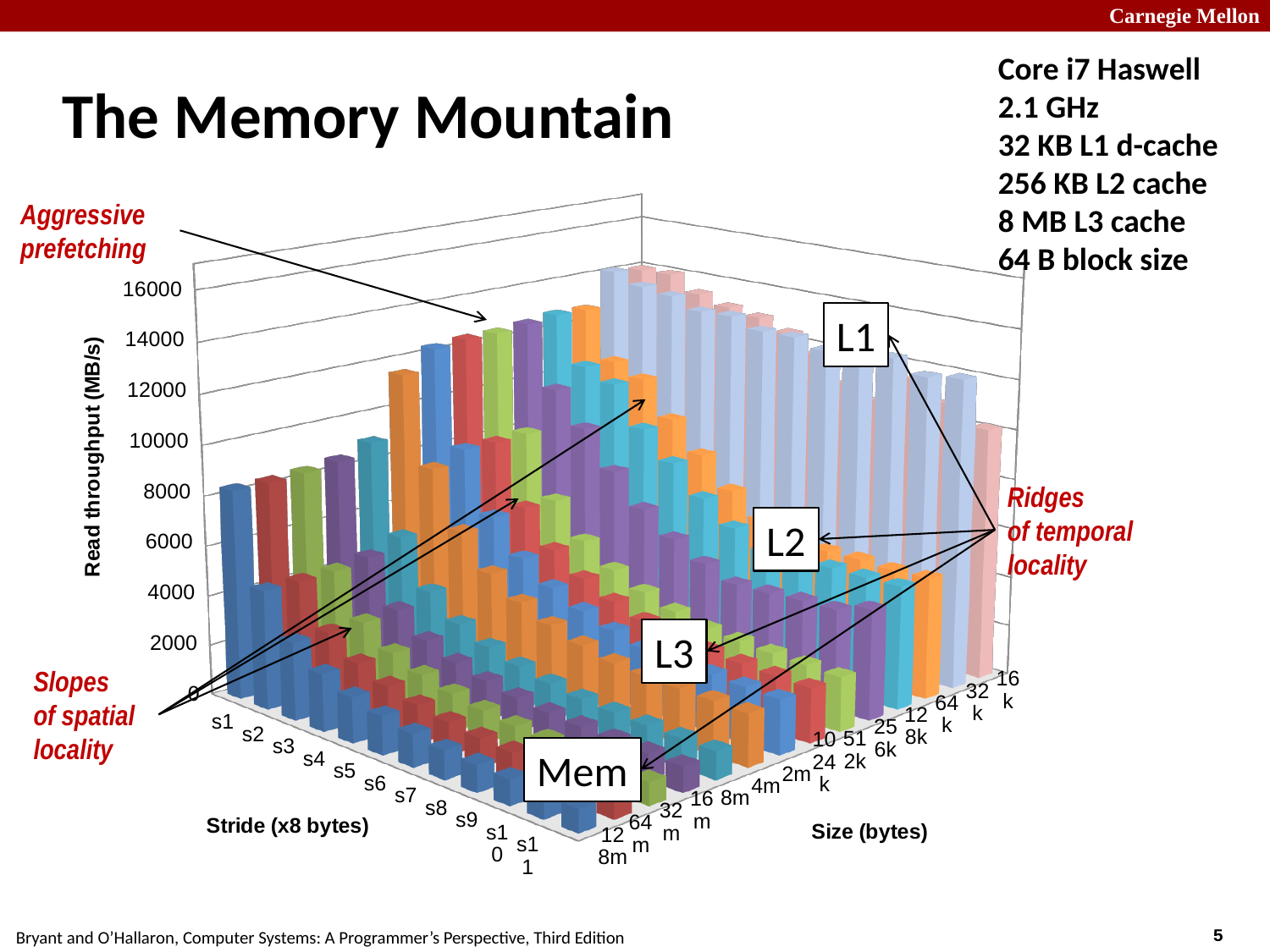
What is the title of the chart on the slide? The Memory Mountain For the 128m size, does read throughput rise or fall as the stride increases from s1 to s11? fall Is the read throughput for stride s1 at size 128m greater or less than 12000? less How many stride categories (s1 through s11) are shown on the Stride axis? 11 Is the read throughput for stride s1 at size 16k greater or less than 12000? greater What is the highest tick value shown on the Read throughput axis? 16000 What kind of chart is shown on the slide? bar chart Is the read throughput for stride s1 at size 128m greater or less than 4000? greater What is the label of the vertical axis of the chart? Read throughput (MB/s) For the 128m size, which stride has the highest read throughput? s1 Which is larger, the read throughput for stride s1 at size 16k or for stride s1 at size 128m? stride s1 at size 16k